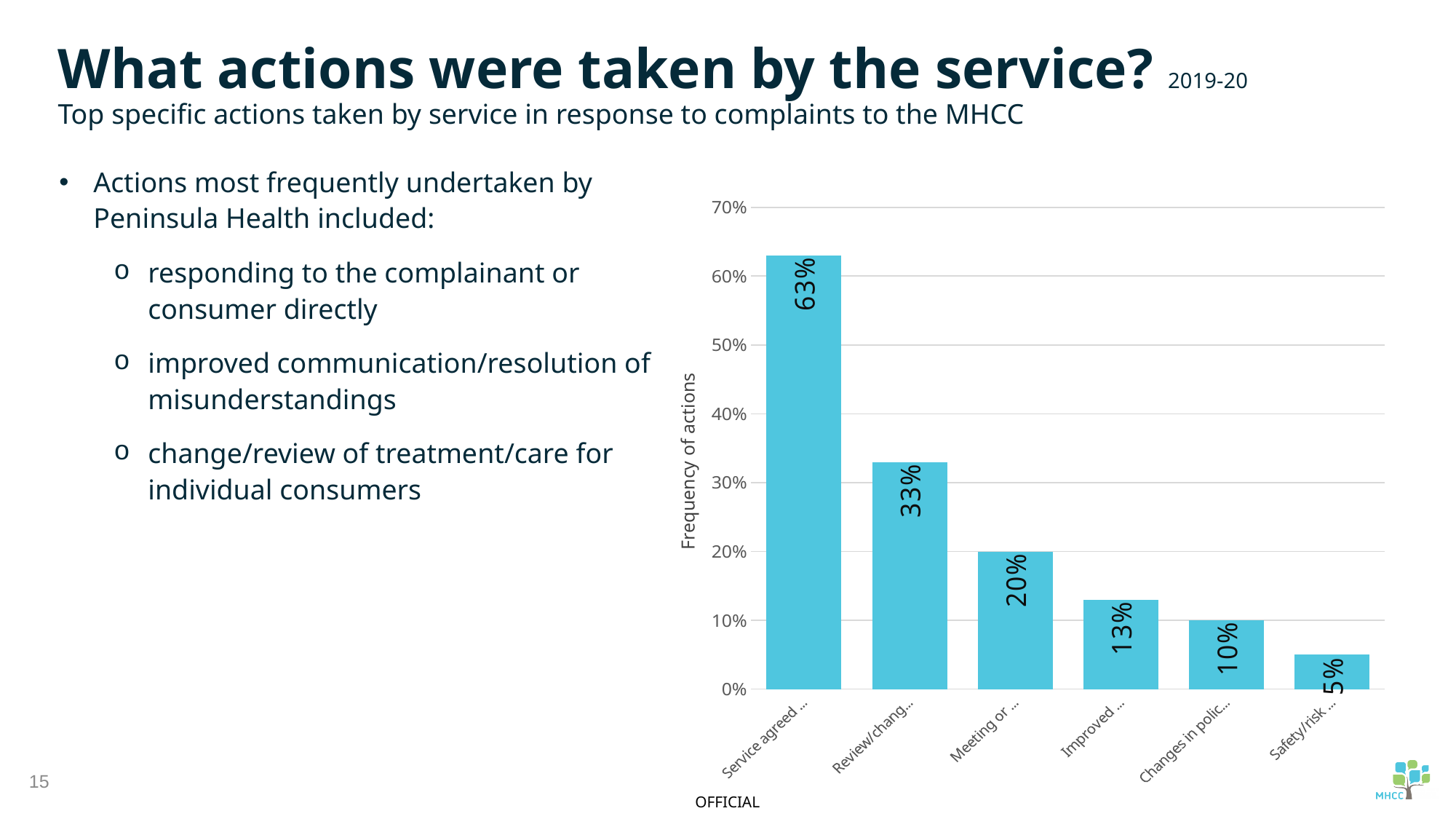
How many bars are plotted in the chart? 6 What is the label of the vertical axis? Frequency of actions Which bar has the highest value? Service agreed ... Which bar has the lowest value? Safety/risk ... What is the value of the first (leftmost) bar, labelled "Service agreed ..."? 63% Which is larger, the value for "Improved ..." or the value for "Changes in polic..."? Improved ... What is the value of the bar labelled "Review/chang..."? 33% What is the value of the bar labelled "Meeting or ..."? 20% What is the difference between the values of the first bar ("Service agreed ...") and the second bar ("Review/chang...")? 30% Do the bar values rise or fall from left to right along the x axis? fall What is the value of the bar labelled "Safety/risk ..."? 5% What kind of chart is shown on the slide? bar chart